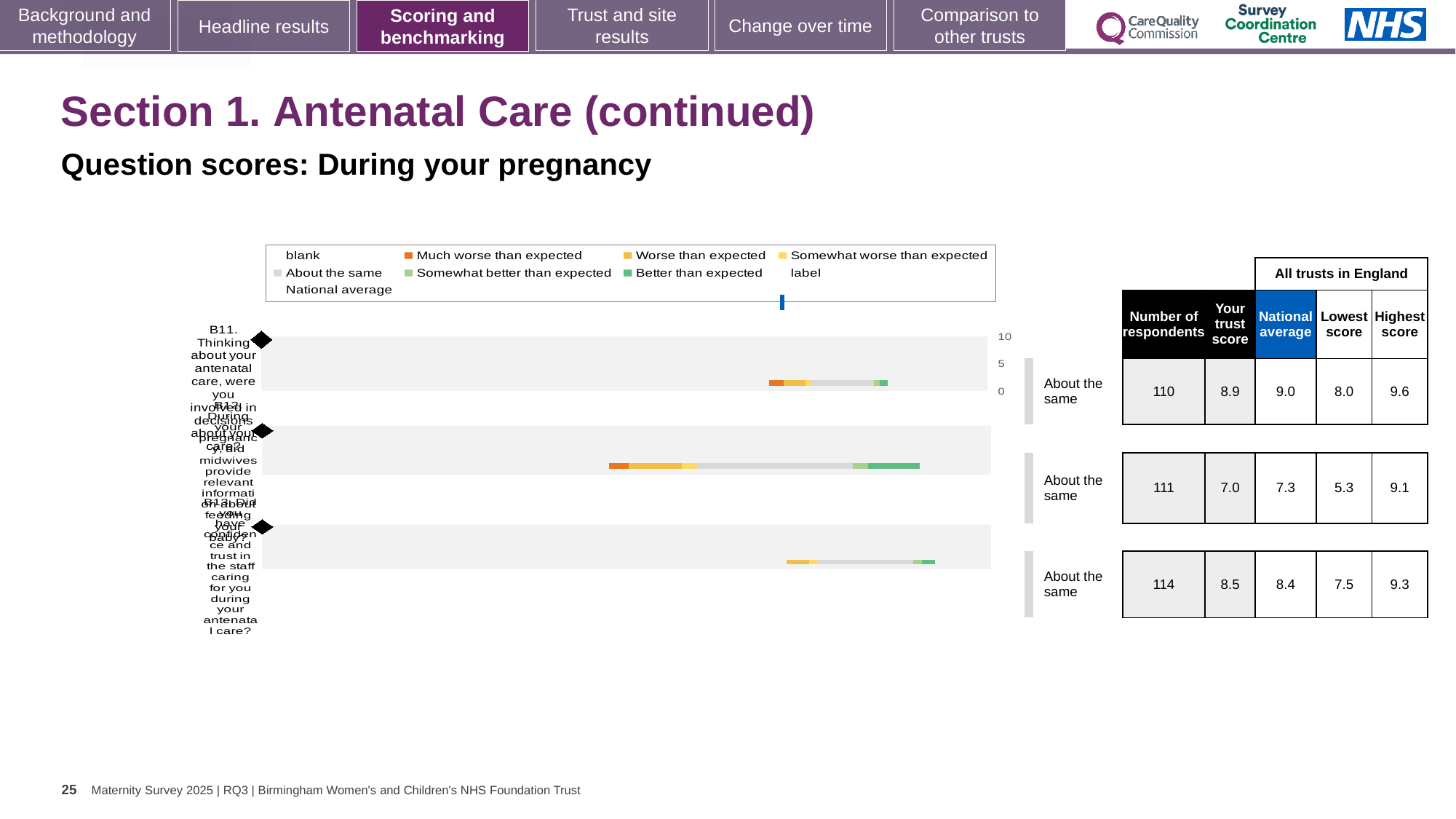
What colour represents 'Much worse than expected' in the chart legend? orange What benchmark label is shown next to the bar for question B12? About the same What colour represents 'Better than expected' in the chart legend? green In the table beside the chart, what is the difference between the national average and the trust score for question B12? 0.3 In the table beside the chart, is the trust score for question B13 higher or lower than the national average? higher In the table beside the chart, which question has the lowest 'Your trust score'? B12 How many question rows (bars) does the chart show? 3 What benchmark label is shown next to the bar for question B11? About the same In the table beside the chart, what is the number of respondents for question B13? 114 What kind of chart is shown on the slide? bar chart In the table beside the chart, what is the 'Your trust score' for question B11? 8.9 How many entries does the chart's legend list? 9